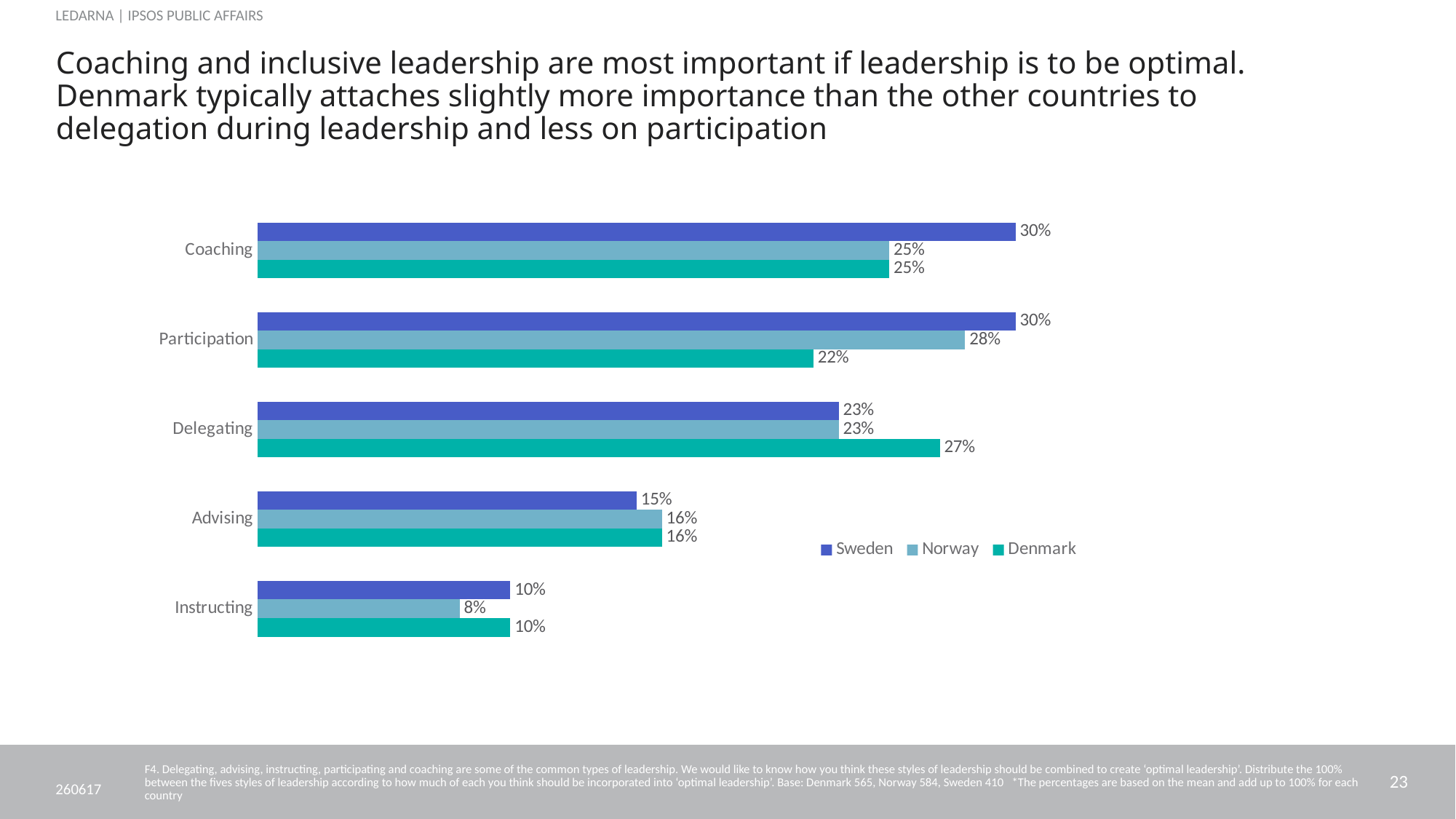
How many series does the legend list? 3 Which category has the lowest value for Sweden? Instructing What is the difference between Norway and Denmark in the Participation category? 6% Which country is represented by the teal (green) bars in the legend? Denmark What is the value for Norway in the Instructing category? 8% How many leadership style categories are shown in the chart? 5 What is the value for Sweden in the Coaching category? 30% Which is larger: Sweden's value for Participation or Denmark's value for Participation? Sweden What is the value for Denmark in the Delegating category? 27% What kind of chart is shown on the slide? Bar chart Which country has the highest value in the Delegating category? Denmark What is the value for Denmark in the Participation category? 22%